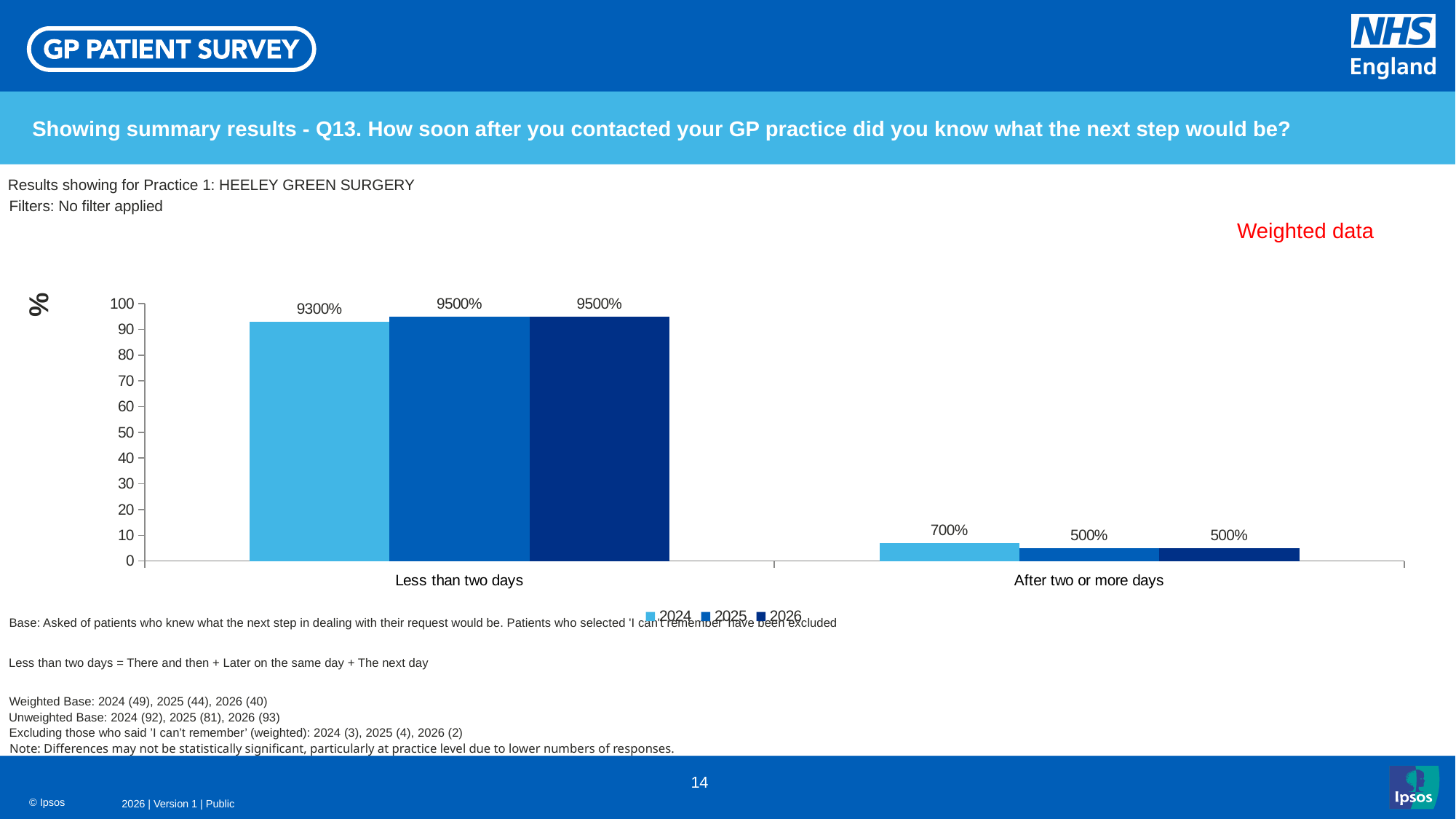
Is the 2025 bar for 'Less than two days' greater or less than 90 on the axis? greater Which category has the highest bars on the chart? Less than two days Which category has the lowest bars on the chart? After two or more days How many categories are shown on the x axis? 2 What is the data label for 2024 in the 'After two or more days' category? 700% What is the data label for 2024 in the 'Less than two days' category? 9300% What kind of chart is shown on the slide? Bar chart Is the 2024 bar for 'After two or more days' greater or less than 10 on the axis? less How many series does the legend list? 3 What is the data label for 2026 in the 'After two or more days' category? 500% Which is larger: the 2024 bar for 'Less than two days' or the 2024 bar for 'After two or more days'? Less than two days What is the data label for 2025 in the 'Less than two days' category? 9500%